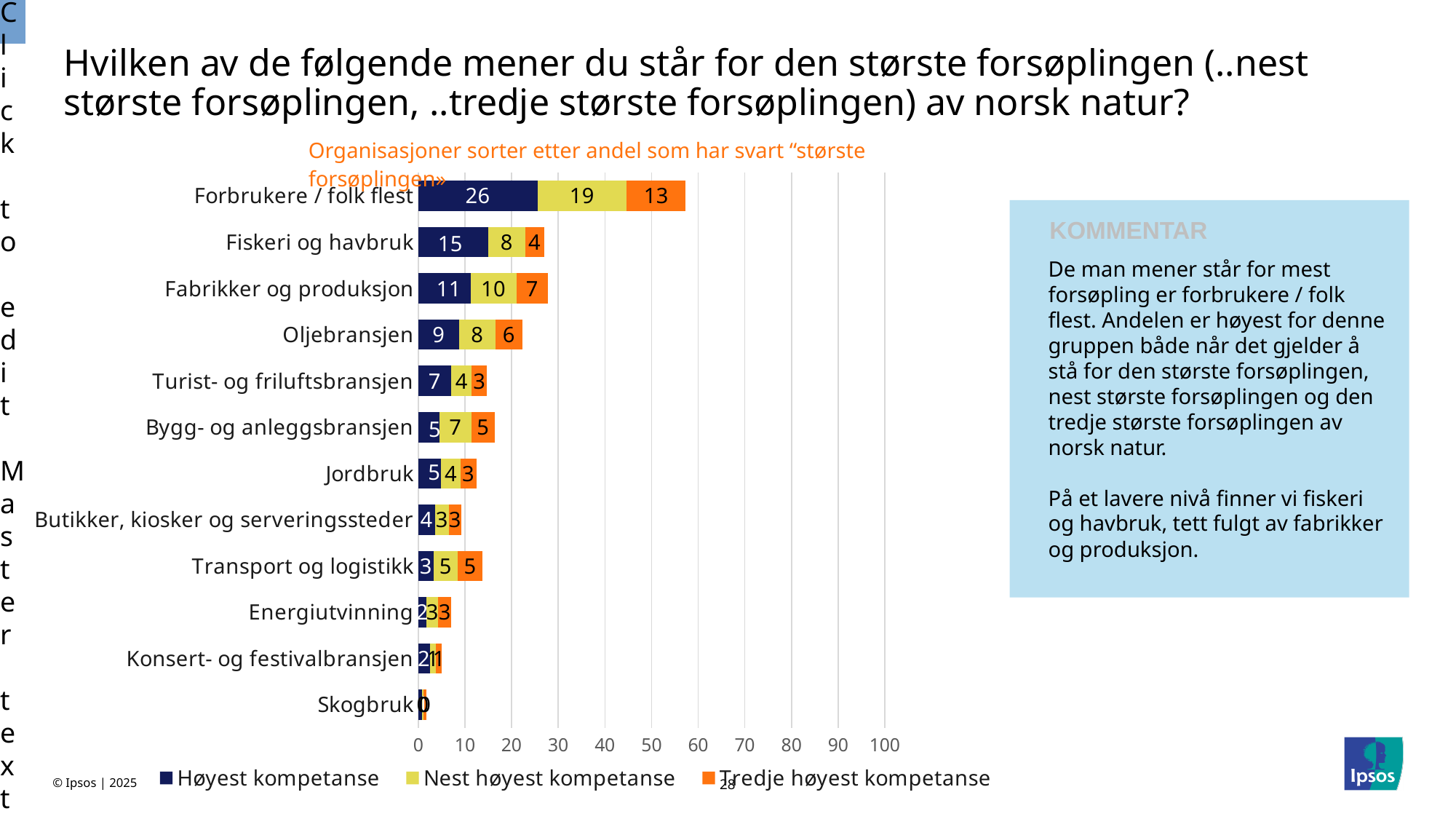
How many categories are plotted on the chart? 12 What type of chart is shown on the slide? Stacked bar chart What is the value of the 'Høyest kompetanse' series for 'Forbrukere / folk flest'? 26 Which category has the highest value in the 'Høyest kompetanse' series? Forbrukere / folk flest What is the total of the stacked bar for 'Forbrukere / folk flest'? 58 What is the value of the 'Nest høyest kompetanse' series for 'Fabrikker og produksjon'? 10 What is the total of the stacked bar for 'Fiskeri og havbruk'? 27 What is the orange subtitle text above the chart? Organisasjoner sorter etter andel som har svart “største forsøplingen» How many series does the legend list? 3 What is the value of the 'Tredje høyest kompetanse' series for 'Oljebransjen'? 6 What is the difference between the 'Høyest kompetanse' values for 'Forbrukere / folk flest' and 'Fiskeri og havbruk'? 11 Which is larger: the 'Nest høyest kompetanse' value for 'Bygg- og anleggsbransjen' or for 'Jordbruk'? Bygg- og anleggsbransjen